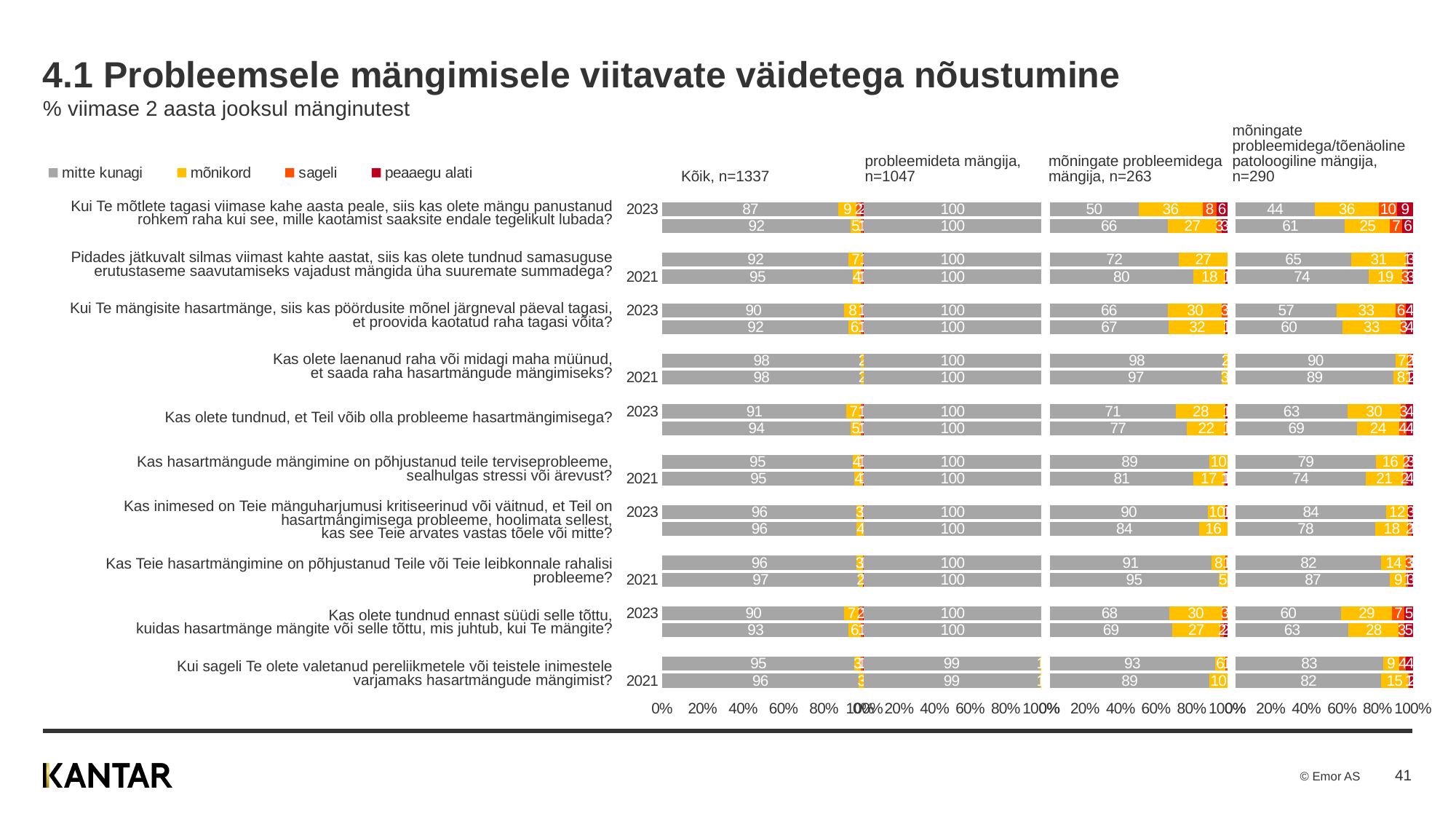
In the 'mõningate probleemidega/tõenäoline patoloogiline mängija, n=290' chart, which statement has the highest 'mitte kunagi' value for 2023? Kas olete laenanud raha või midagi maha müünud, et saada raha hasartmängude mängimiseks? What kind of chart is used on this slide? Stacked bar chart In the 'Kõik, n=1337' chart, what is the 'mitte kunagi' value for 2023 for the statement about betting more money than you could afford to lose (first row)? 87 In the 'probleemideta mängija, n=1047' chart, what is the 'mitte kunagi' value for 2023 for the last statement about lying to family members? 99 In the 'mõningate probleemidega/tõenäoline patoloogiline mängija, n=290' chart, what is the 'mõnikord' value for 2021 for the statement about health problems including stress or anxiety? 21 In the 'mõningate probleemidega/tõenäoline patoloogiline mängija, n=290' chart, what is the difference between the 2021 and 2023 'mitte kunagi' values in the first row (61 vs 44)? 17 In the 'mõningate probleemidega mängija, n=263' chart, what is the 'mõnikord' value for 2023 in the first row (betting more money than you could afford to lose)? 36 In the 'Kõik, n=1337' chart, which statement has the lowest 'mitte kunagi' value for 2023? Kui Te mõtlete tagasi viimase kahe aasta peale, siis kas olete mängu panustanud rohkem raha kui see, mille kaotamist saaksite endale tegelikult lubada? How many statements (question rows) are shown in each chart? 10 How many series does the legend list? 4 In the 'mõningate probleemidega mängija, n=263' chart, is the 2023 'mitte kunagi' value for 'Kas olete tundnud, et Teil võib olla probleeme hasartmängimisega?' larger or smaller than the 2021 value? Smaller (71 vs 77) In the 'mõningate probleemidega/tõenäoline patoloogiline mängija, n=290' chart, what is the 'mitte kunagi' value for 2023 in the first row? 44